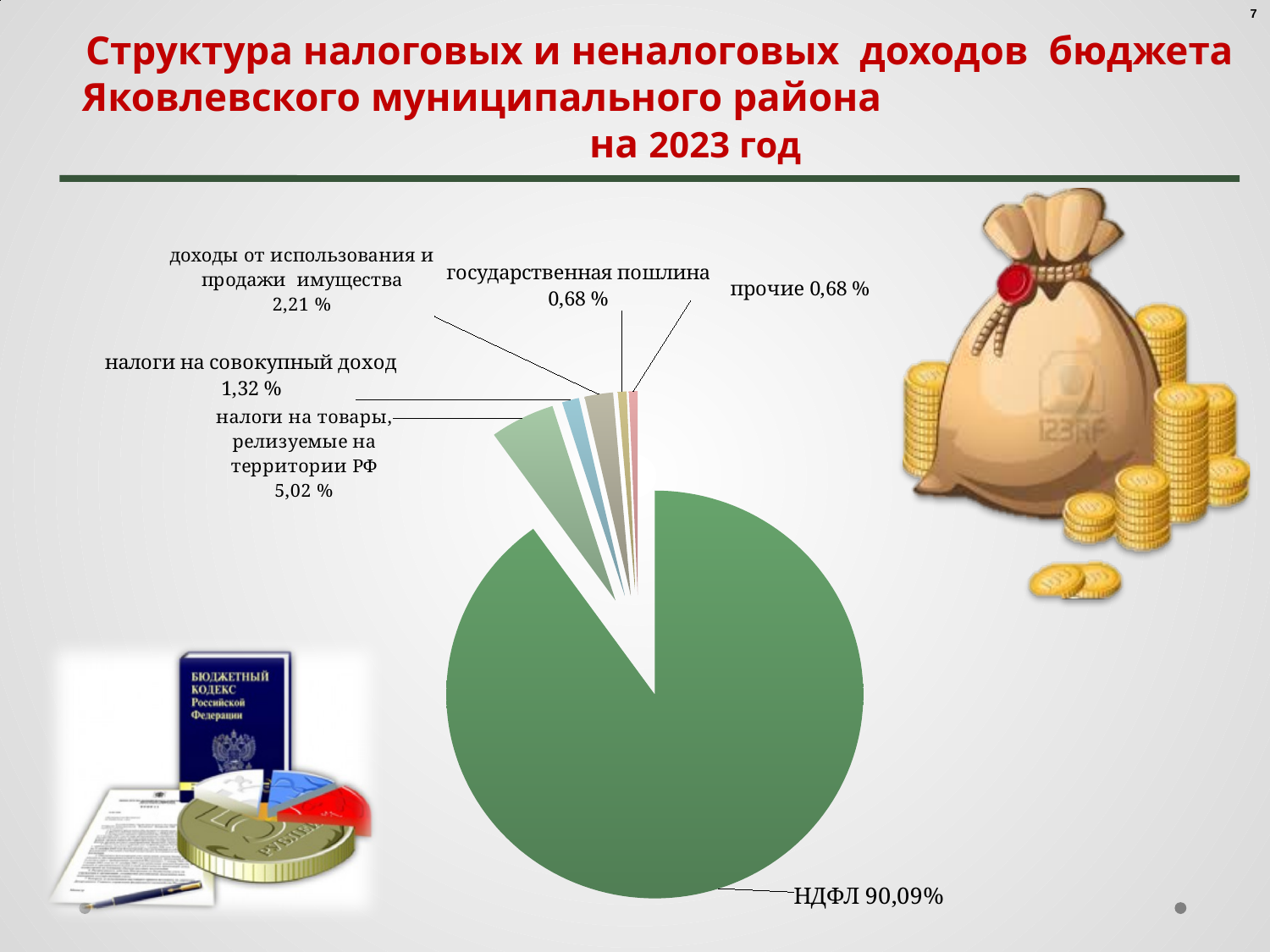
Which is larger: доходы от использования и продажи имущества or налоги на совокупный доход? доходы от использования и продажи имущества Which category has the largest share of the pie? НДФЛ What is the difference between налоги на товары, реализуемые на территории РФ and доходы от использования и продажи имущества? 2,81 % How many slices does the pie chart have? 6 What share of the budget revenue does НДФЛ account for? 90,09% What year does the chart title refer to? 2023 What is the difference between the shares of НДФЛ and налоги на товары, реализуемые на территории РФ? 85,07 % What type of chart is shown on the slide? Pie chart What is the value for налоги на совокупный доход? 1,32 % What is the value for доходы от использования и продажи имущества? 2,21 % What is the value for государственная пошлина? 0,68 % What is the value for налоги на товары, реализуемые на территории РФ? 5,02 %